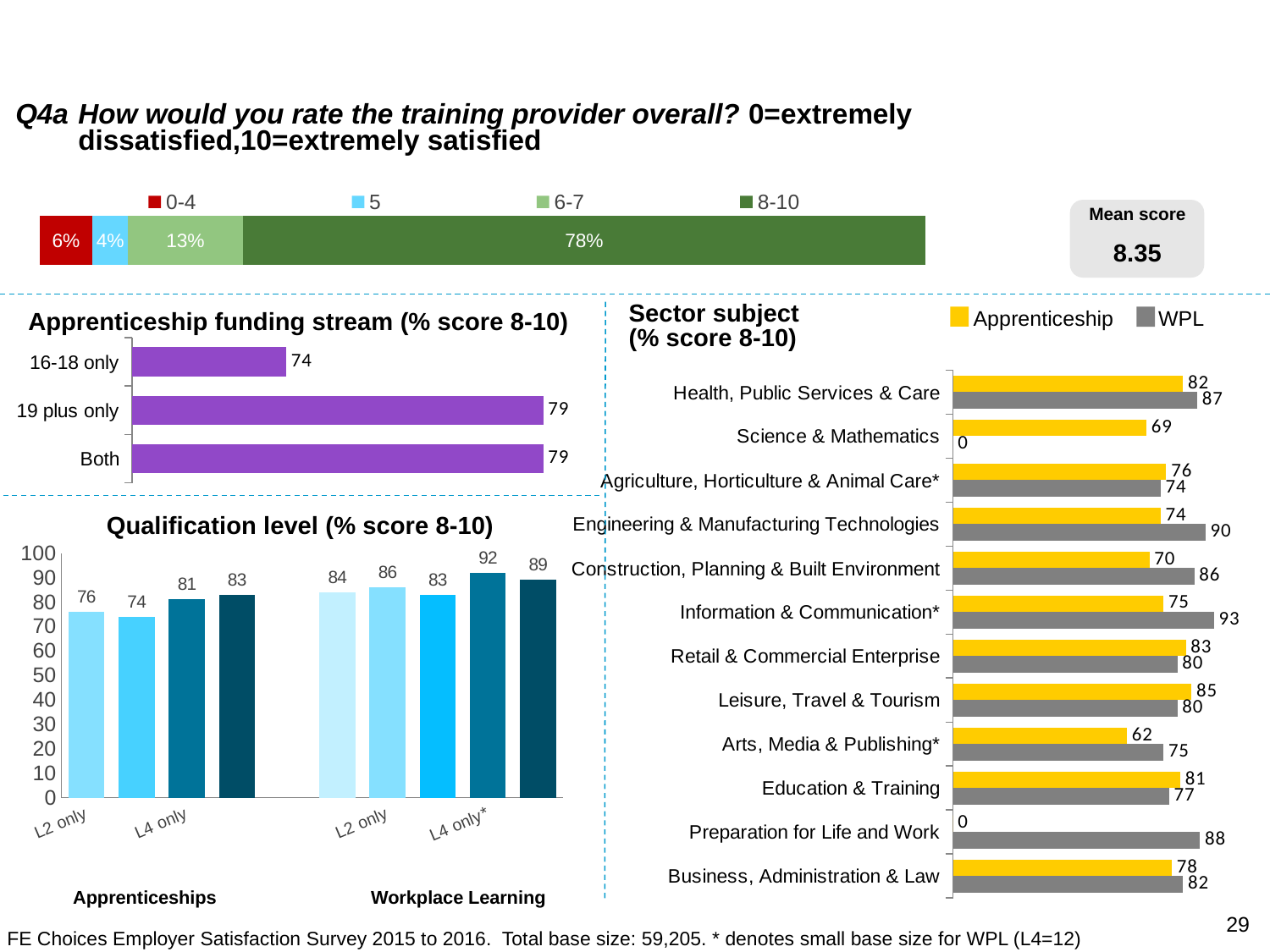
In the Apprenticeship funding stream chart, what is the value for 16-18 only? 74 In the top stacked bar chart, what percentage of employers gave a score of 8-10? 78% What kind of chart is the Apprenticeship funding stream chart? Bar chart How many series does the legend of the Sector subject chart list? 2 In the Sector subject chart, what is the Apprenticeship value for Arts, Media & Publishing*? 62 In the Apprenticeship funding stream chart, how many categories are shown? 3 In the Sector subject chart, what is the WPL value for Information & Communication*? 93 In the Apprenticeship funding stream chart, which category has the lowest value? 16-18 only In the Qualification level chart, what is the highest value shown? 92 In the Sector subject chart, which is larger for Retail & Commercial Enterprise, the Apprenticeship value or the WPL value? Apprenticeship What is the mean score shown on the slide? 8.35 In the Sector subject chart, what is the difference between the WPL and Apprenticeship values for Engineering & Manufacturing Technologies? 16